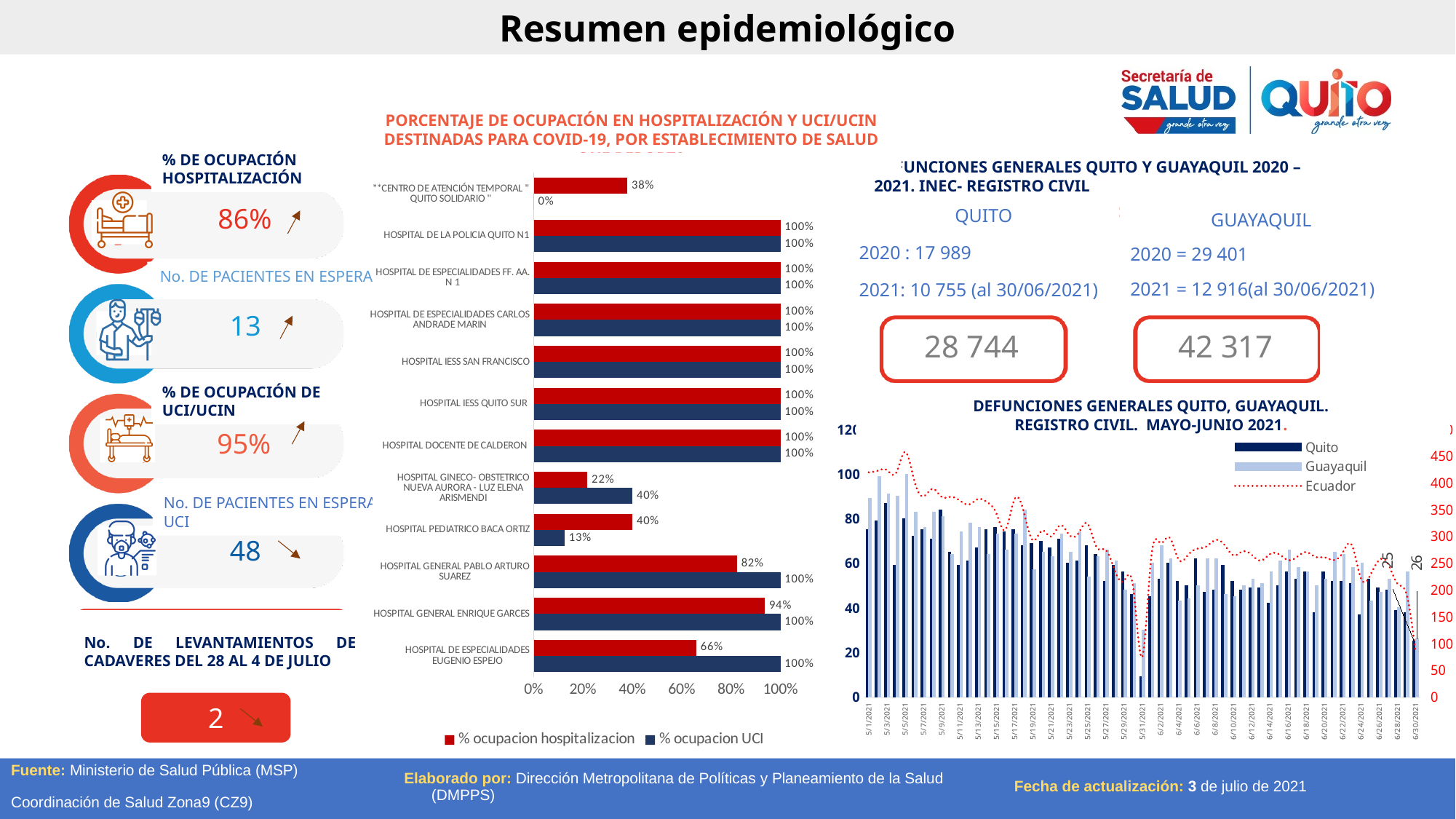
In the chart 'DEFUNCIONES GENERALES QUITO, GUAYAQUIL. REGISTRO CIVIL. MAYO-JUNIO 2021', which series is drawn as a dotted line? Ecuador In the chart 'PORCENTAJE DE OCUPACIÓN EN HOSPITALIZACIÓN Y UCI/UCIN', what is the % ocupacion UCI for CENTRO DE ATENCIÓN TEMPORAL QUITO SOLIDARIO? 0% What kind of chart is 'PORCENTAJE DE OCUPACIÓN EN HOSPITALIZACIÓN Y UCI/UCIN'? Bar chart In the chart 'PORCENTAJE DE OCUPACIÓN EN HOSPITALIZACIÓN Y UCI/UCIN', what is the % ocupacion hospitalizacion for HOSPITAL DE ESPECIALIDADES EUGENIO ESPEJO? 66% In the chart 'PORCENTAJE DE OCUPACIÓN EN HOSPITALIZACIÓN Y UCI/UCIN', which establishment has the lowest % ocupacion hospitalizacion? HOSPITAL GINECO- OBSTETRICO NUEVA AURORA - LUZ ELENA ARISMENDI In the chart 'PORCENTAJE DE OCUPACIÓN EN HOSPITALIZACIÓN Y UCI/UCIN', how many establishments are listed? 12 In the chart 'PORCENTAJE DE OCUPACIÓN EN HOSPITALIZACIÓN Y UCI/UCIN', what is the % ocupacion UCI for HOSPITAL PEDIATRICO BACA ORTIZ? 13% In the chart 'PORCENTAJE DE OCUPACIÓN EN HOSPITALIZACIÓN Y UCI/UCIN', how many series does the legend list? 2 In the chart 'PORCENTAJE DE OCUPACIÓN EN HOSPITALIZACIÓN Y UCI/UCIN', what is the difference between the % ocupacion UCI and the % ocupacion hospitalizacion for HOSPITAL GENERAL PABLO ARTURO SUAREZ? 18% In the chart 'PORCENTAJE DE OCUPACIÓN EN HOSPITALIZACIÓN Y UCI/UCIN', what is the % ocupacion hospitalizacion for HOSPITAL GENERAL ENRIQUE GARCES? 94% In the chart 'DEFUNCIONES GENERALES QUITO, GUAYAQUIL. REGISTRO CIVIL. MAYO-JUNIO 2021', how many series does the legend list? 3 In the chart 'PORCENTAJE DE OCUPACIÓN EN HOSPITALIZACIÓN Y UCI/UCIN', which is larger for HOSPITAL PEDIATRICO BACA ORTIZ: % ocupacion hospitalizacion or % ocupacion UCI? % ocupacion hospitalizacion